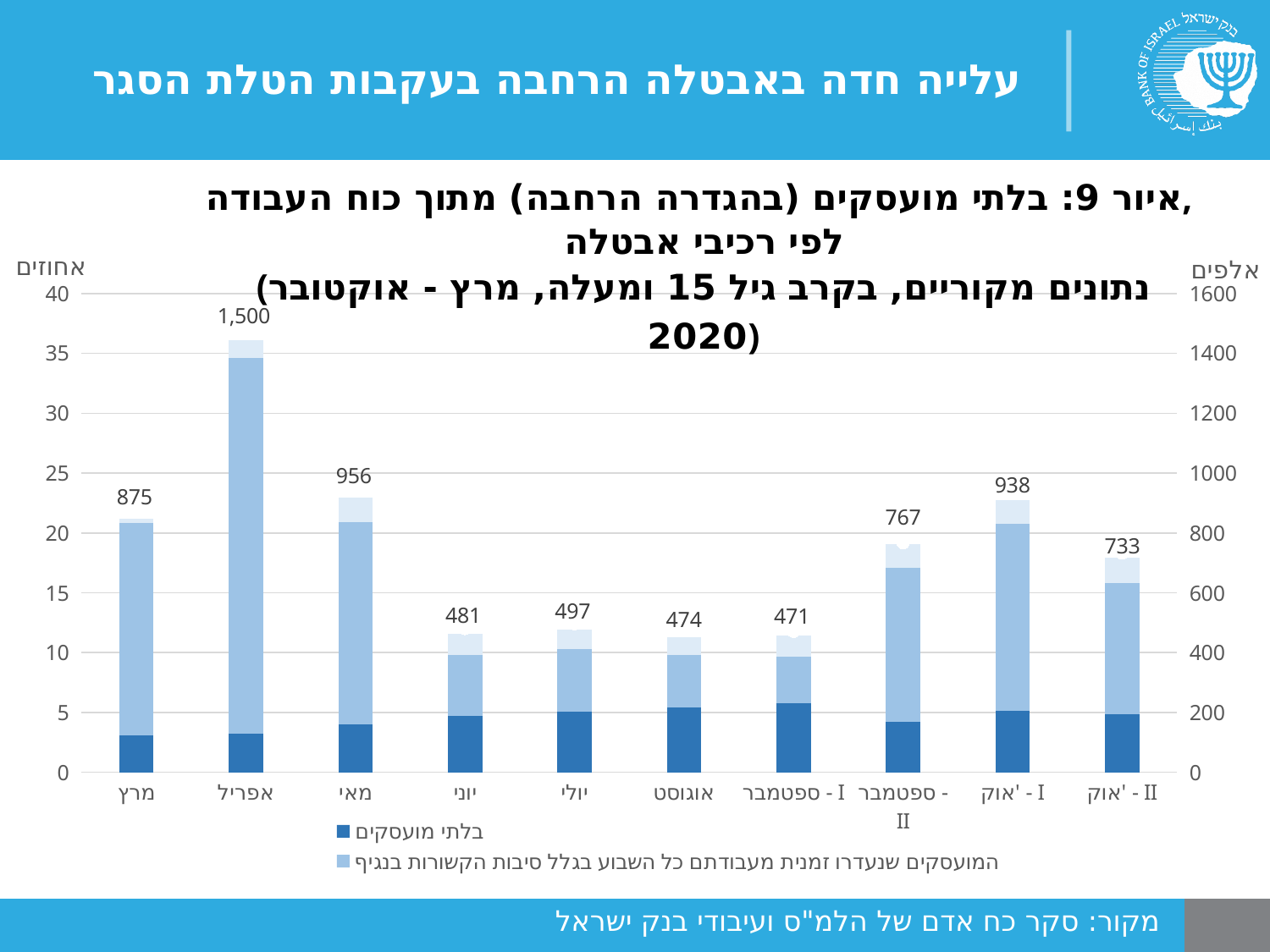
What kind of chart is shown on the slide? Stacked bar chart What is the data label shown for מרץ (March)? 875 Which category has the lowest labelled value? ספטמבר - I What is the data label shown for אפריל (April)? 1,500 What is the unit label shown on the right-hand axis? אלפים Which month has the highest labelled value? אפריל How many series does the legend list? 2 How many categories are shown on the x axis? 10 Which has a larger labelled value, מאי or אוק' - I? מאי What is the data label shown for ספטמבר - II? 767 What is the difference between the labelled values for אפריל and מרץ? 625 What is the data label shown for אוק' - II? 733